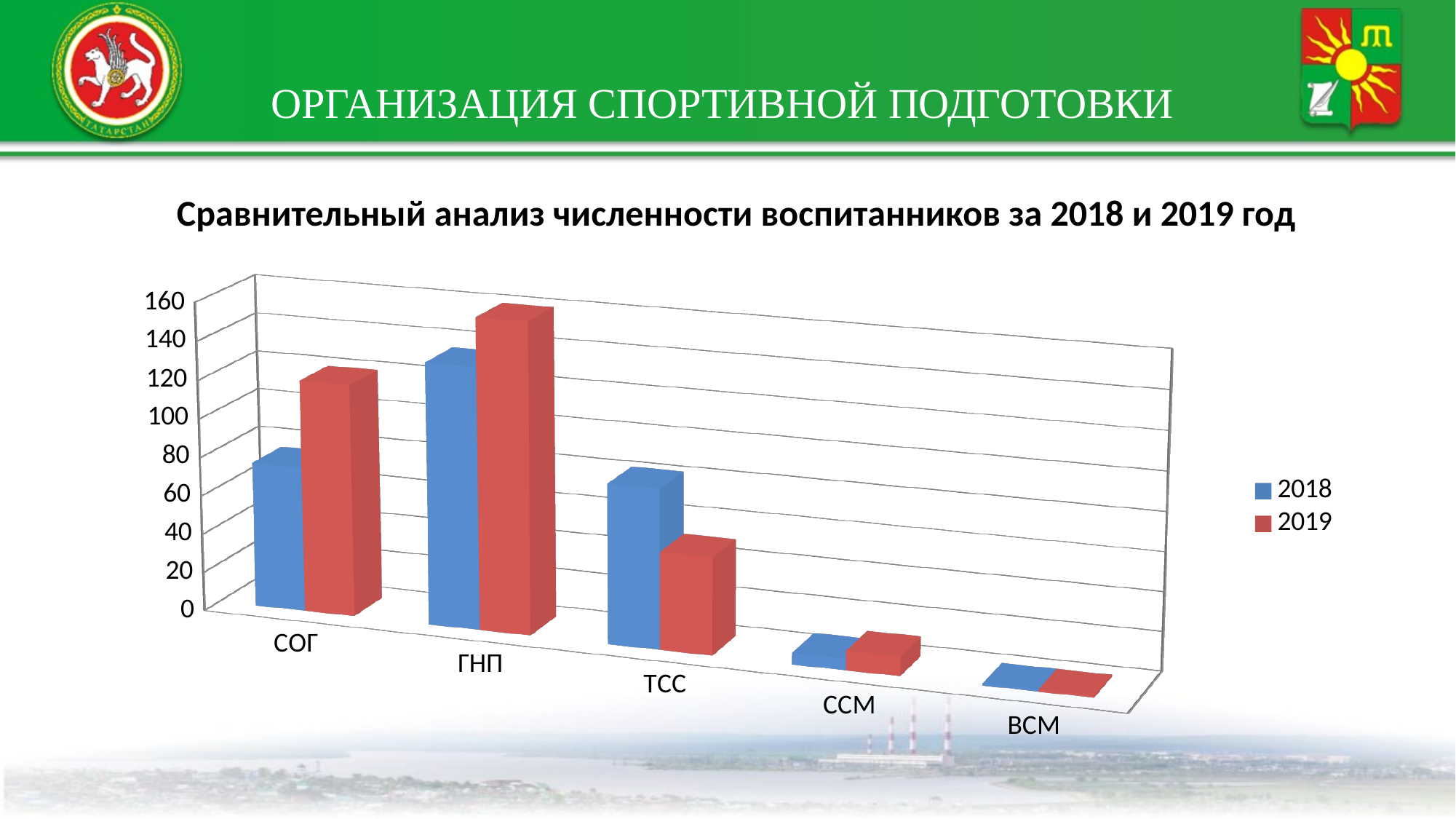
Is the value for ВСМ in 2018 greater or less than 20? less Which category has the lowest value for 2018? ВСМ Which category has the highest value for 2019? ГНП What kind of chart is shown on the slide? bar chart Is the value for ГНП in 2019 greater or less than 100? greater Which colour represents the 2019 series in the chart? red Is the value for СОГ in 2018 greater or less than 100? less Which category has the highest value for 2018? ГНП For ТСС, which year has the larger value, 2018 or 2019? 2018 How many series does the chart legend list? 2 How many categories are shown on the x axis of the chart? 5 For СОГ, which year has the larger value, 2018 or 2019? 2019